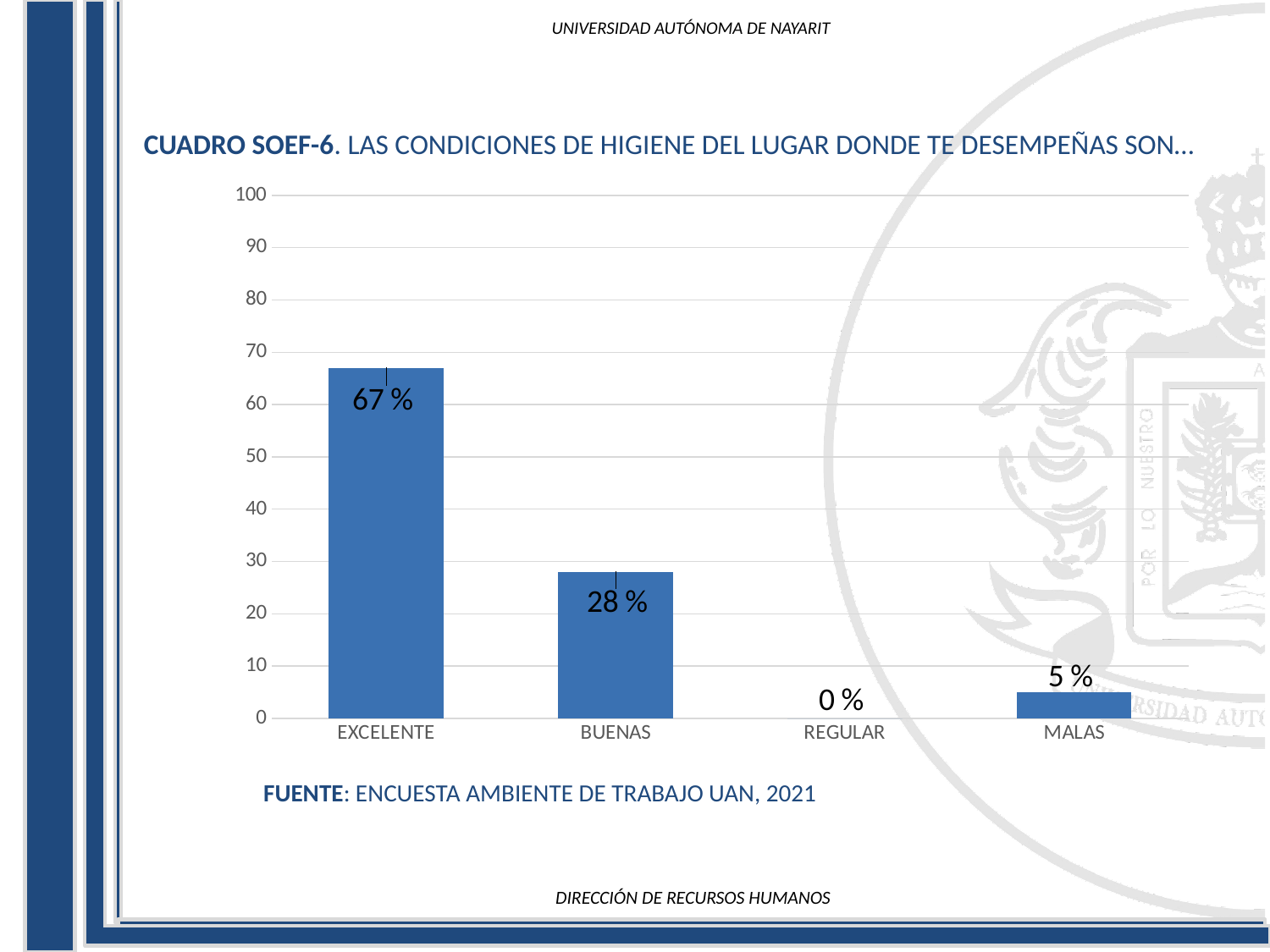
Which is larger, the value for BUENAS or the value for MALAS? BUENAS What is the difference between the values for EXCELENTE and BUENAS? 39 % Which category has the highest value? EXCELENTE What is the source cited below the chart? ENCUESTA AMBIENTE DE TRABAJO UAN, 2021 What kind of chart is shown on the slide? bar chart Which category has the lowest value? REGULAR Is the value for EXCELENTE greater or less than 60? greater What is the value for BUENAS? 28 % What is the value for MALAS? 5 % What is the value for REGULAR? 0 % How many categories are shown on the x axis? 4 What is the value for EXCELENTE? 67 %